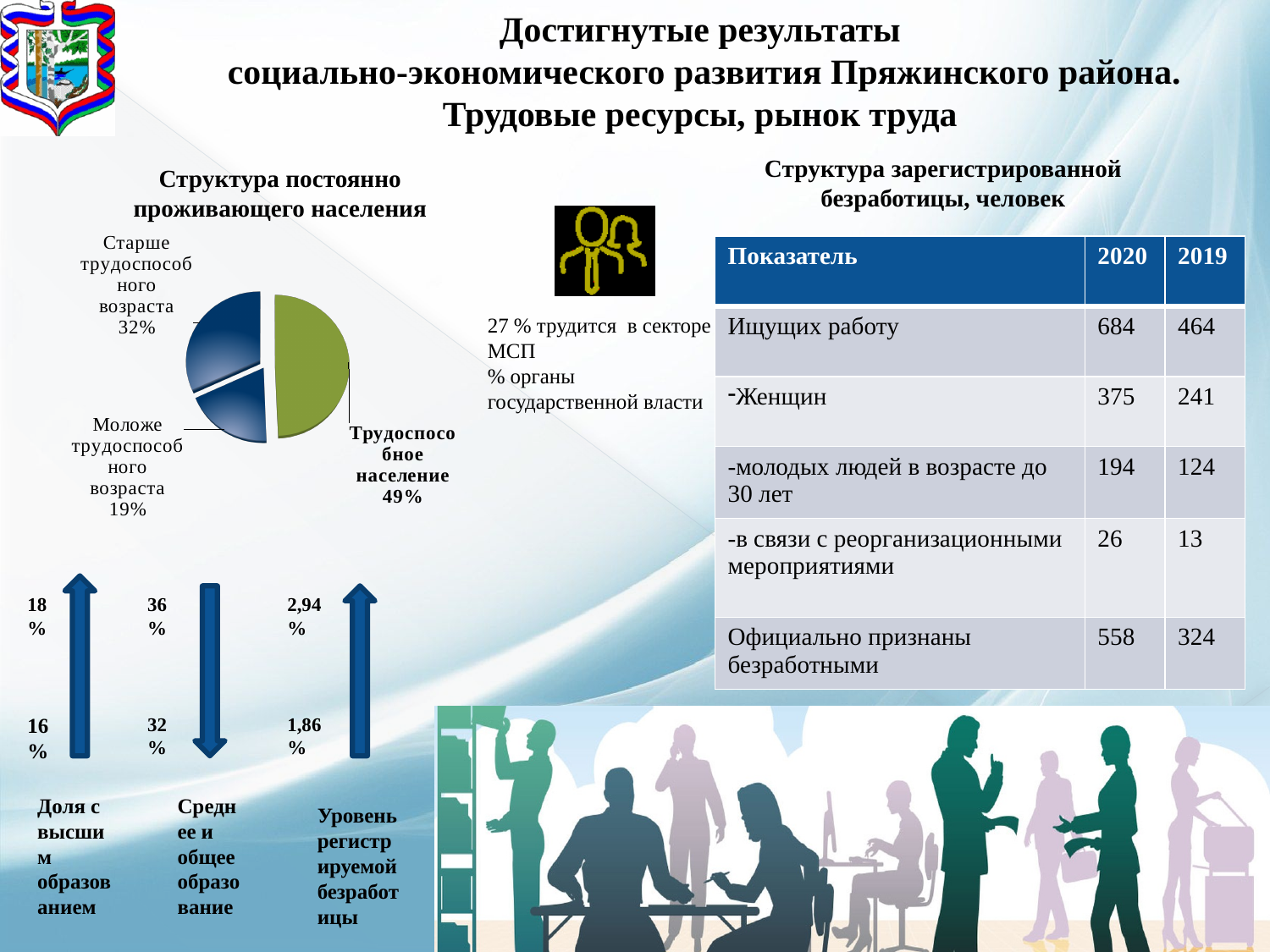
In the pie chart "Структура постоянно проживающего населения", what share is "Старше трудоспособного возраста"? 32% In the pie chart "Структура постоянно проживающего населения", what is the difference in percentage points between "Старше трудоспособного возраста" and "Моложе трудоспособного возраста"? 13 In the pie chart "Структура постоянно проживающего населения", which category has the smallest share? Моложе трудоспособного возраста In the pie chart "Структура постоянно проживающего населения", which category has the largest share? Трудоспособное население In the pie chart "Структура постоянно проживающего населения", what is the difference in percentage points between "Трудоспособное население" and "Старше трудоспособного возраста"? 17 In the pie chart "Структура постоянно проживающего населения", what share is "Моложе трудоспособного возраста"? 19% In the pie chart "Структура постоянно проживающего населения", what colour is the "Трудоспособное население" slice? green In the pie chart "Структура постоянно проживающего населения", what share is "Трудоспособное население"? 49% How many slices does the pie chart "Структура постоянно проживающего населения" have? 3 What is the title of the pie chart on the left of the slide? Структура постоянно проживающего населения What kind of chart is used for "Структура постоянно проживающего населения"? pie chart In the pie chart "Структура постоянно проживающего населения", which is larger: "Старше трудоспособного возраста" or "Моложе трудоспособного возраста"? Старше трудоспособного возраста